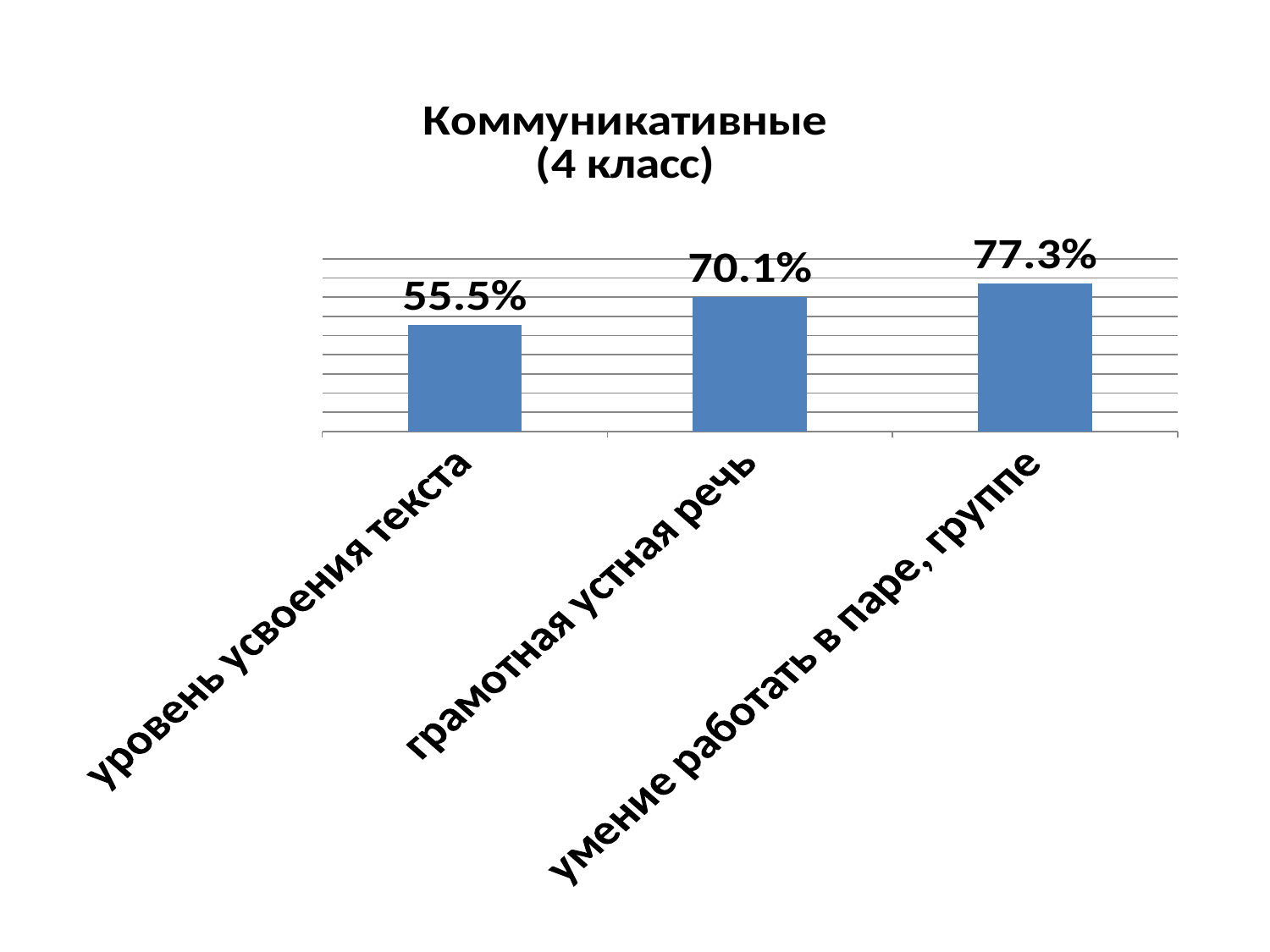
Which category has the lowest value? уровень усвоения текста How many categories are shown in the chart? 3 What is the title of the chart? Коммуникативные (4 класс) What is the difference between the values for "умение работать в паре, группе" and "уровень усвоения текста"? 21.8% What is the value for "грамотная устная речь"? 70.1% What is the difference between the values for "грамотная устная речь" and "уровень усвоения текста"? 14.6% Which category has the highest value? умение работать в паре, группе Which is larger: the value for "грамотная устная речь" or for "уровень усвоения текста"? грамотная устная речь What is the value for "уровень усвоения текста"? 55.5% What is the value for "умение работать в паре, группе"? 77.3% Do the values rise or fall from left to right along the x axis? rise What kind of chart is this? bar chart